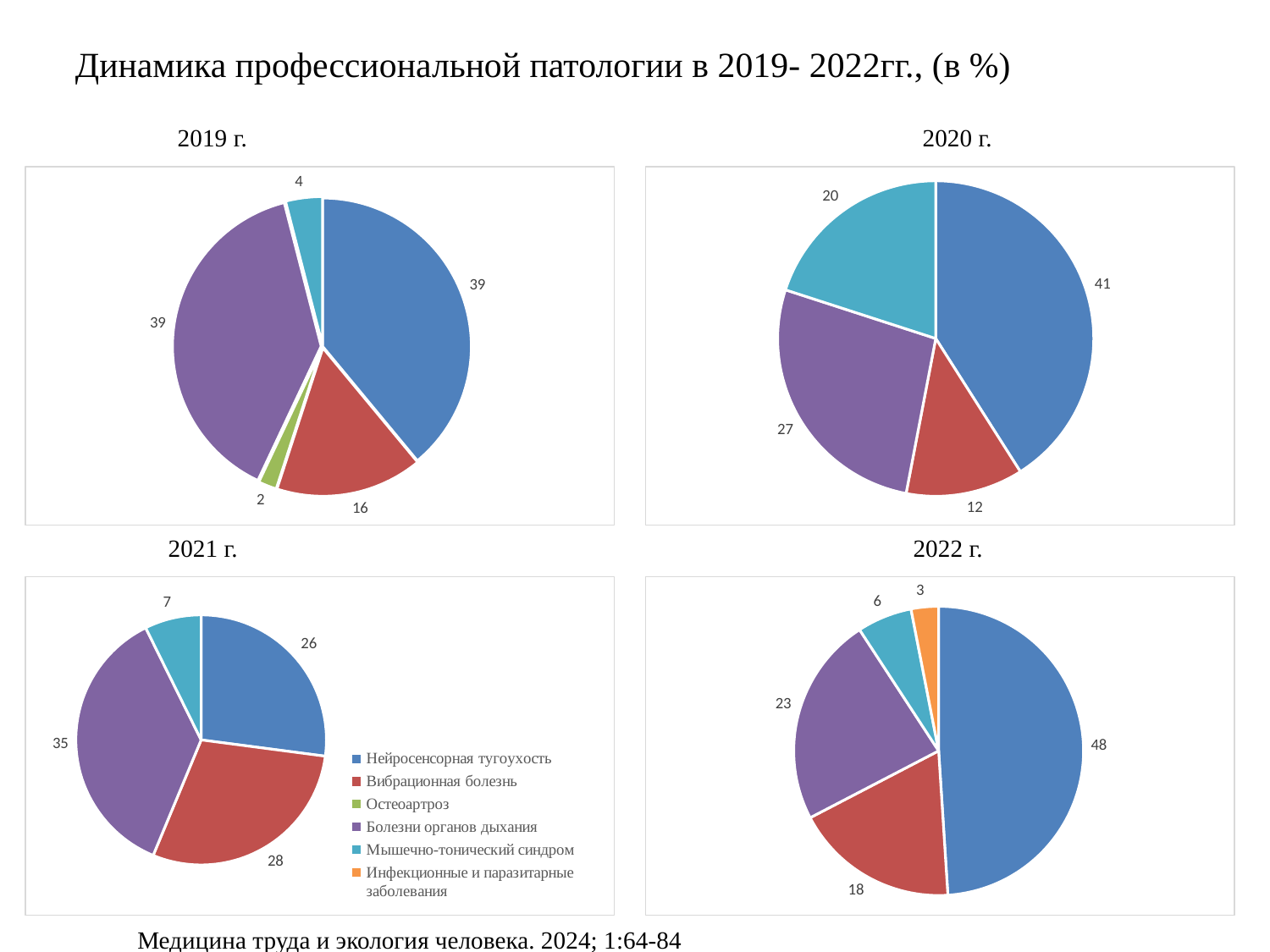
In the 2020 г. pie chart, which category has the largest share? Нейросенсорная тугоухость In the 2022 г. pie chart, which is larger: Вибрационная болезнь or Болезни органов дыхания? Болезни органов дыхания What type of chart is used for each year on this slide? Pie chart In the 2020 г. pie chart, what is the difference between Болезни органов дыхания and Вибрационная болезнь? 15 In the 2021 г. pie chart, which category has the largest share? Болезни органов дыхания How many categories does the legend list? 6 In the 2022 г. pie chart, what is the value for Инфекционные и паразитарные заболевания? 3 In the 2019 г. pie chart, which category has the smallest share? Остеоартроз In the 2020 г. pie chart, what is the value for Мышечно-тонический синдром? 20 How many slices does the 2022 г. pie chart have? 5 In the 2019 г. pie chart, what is the value for Вибрационная болезнь? 16 In the 2021 г. pie chart, what is the value for Нейросенсорная тугоухость? 26